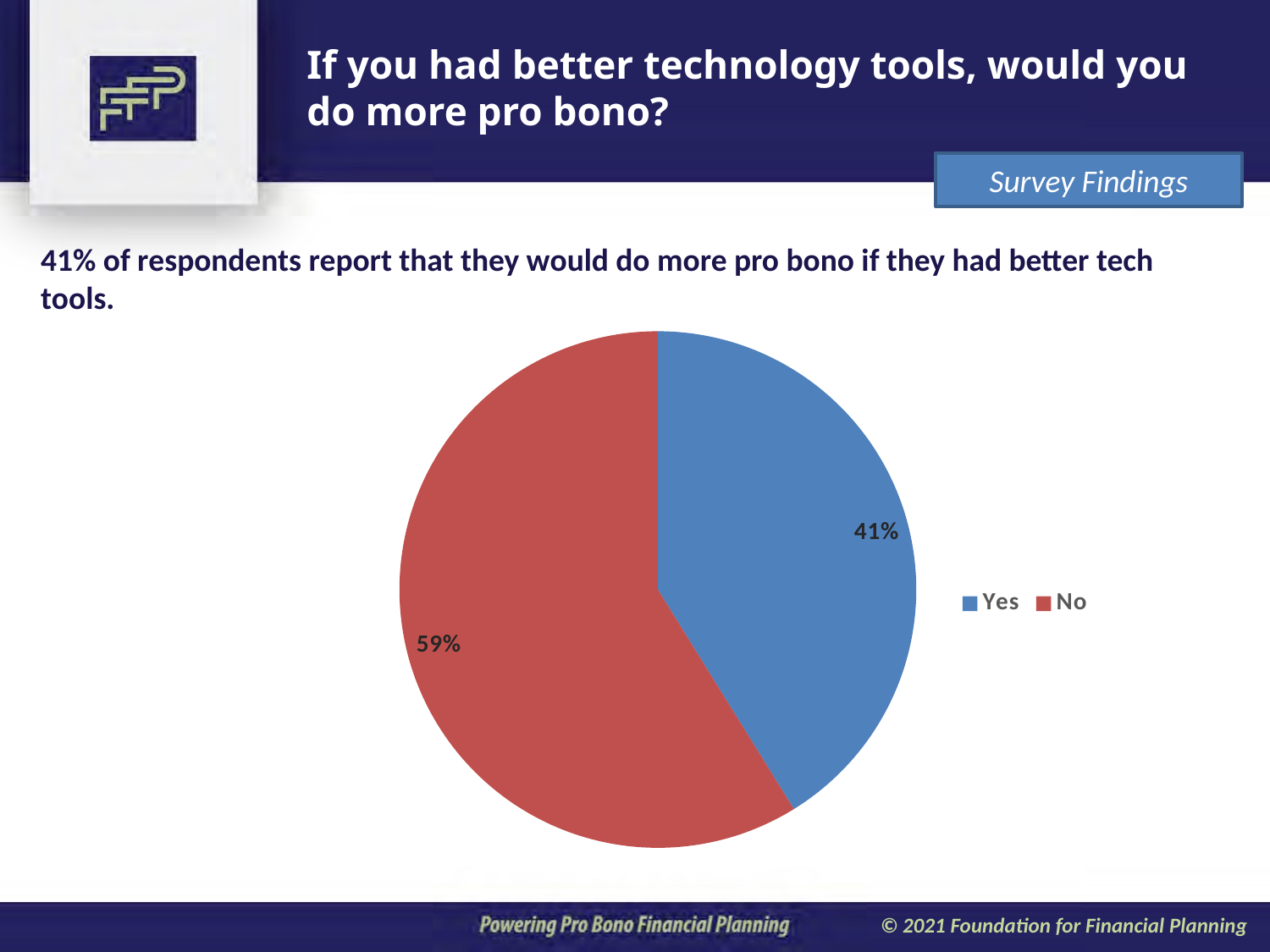
What kind of chart is shown on the slide? pie chart What colour is the No slice? red Which response has the larger share of the pie? No What percentage of respondents answered Yes? 41% How many entries does the legend list? 2 What percentage of respondents answered No? 59% Is the Yes slice larger or smaller than the No slice? smaller How many slices does the pie chart have? 2 What colour is the Yes slice? blue Which response has the smaller share of the pie? Yes What share of the pie does the No slice represent? 59% What is the difference in percentage points between the No and Yes slices? 18